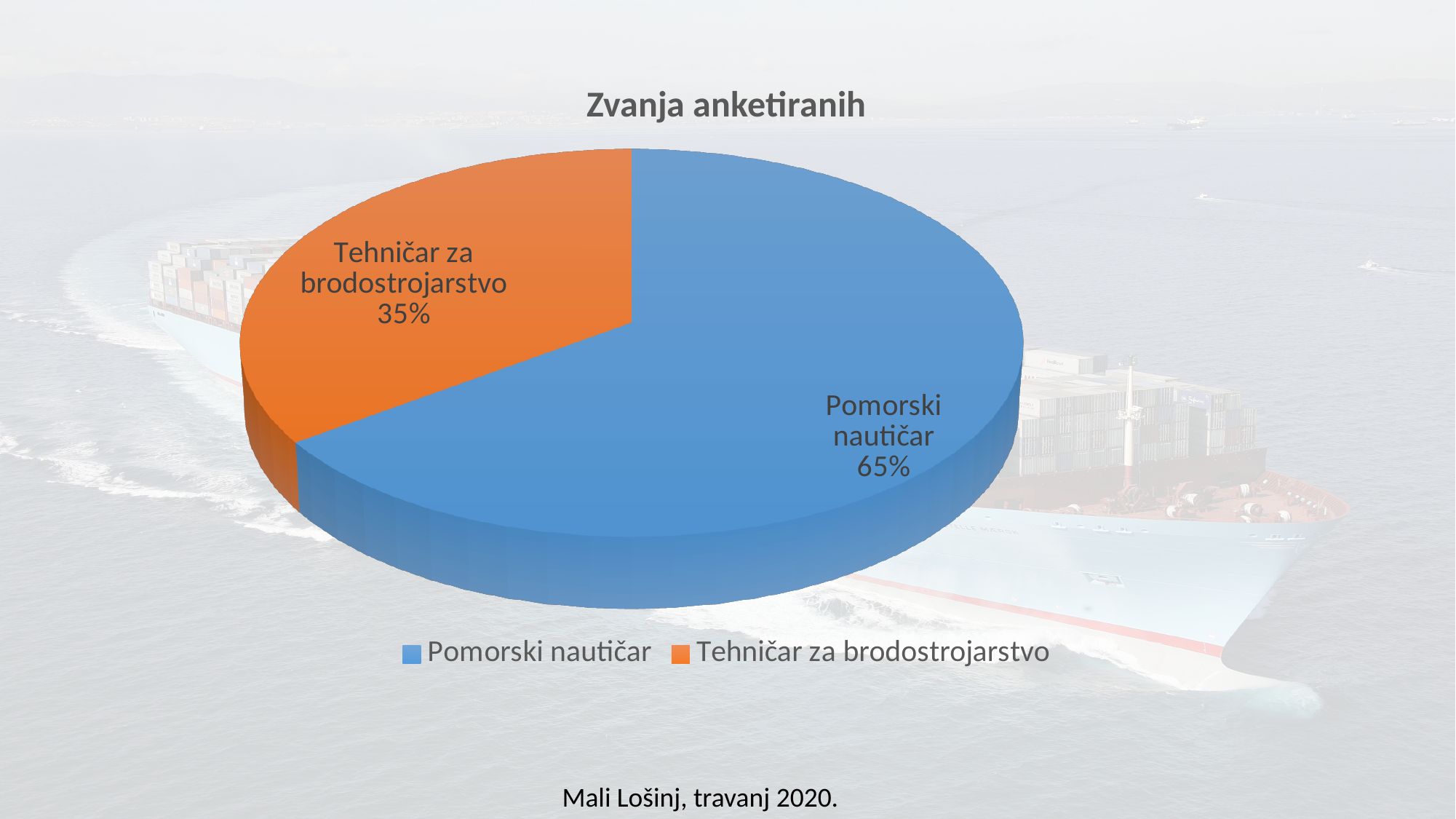
Which is larger, the slice for Pomorski nautičar or the slice for Tehničar za brodostrojarstvo? Pomorski nautičar Which category has the largest slice of the pie? Pomorski nautičar What kind of chart is shown on the slide? pie chart What share of the pie does Pomorski nautičar have? 65% What share of the pie does Tehničar za brodostrojarstvo have? 35% What is the difference in percentage points between Pomorski nautičar and Tehničar za brodostrojarstvo? 30 What colour is the slice for Tehničar za brodostrojarstvo? orange How many slices does the pie chart have? 2 What is the title of the chart? Zvanja anketiranih How many entries does the legend list? 2 Which category has the smallest slice of the pie? Tehničar za brodostrojarstvo